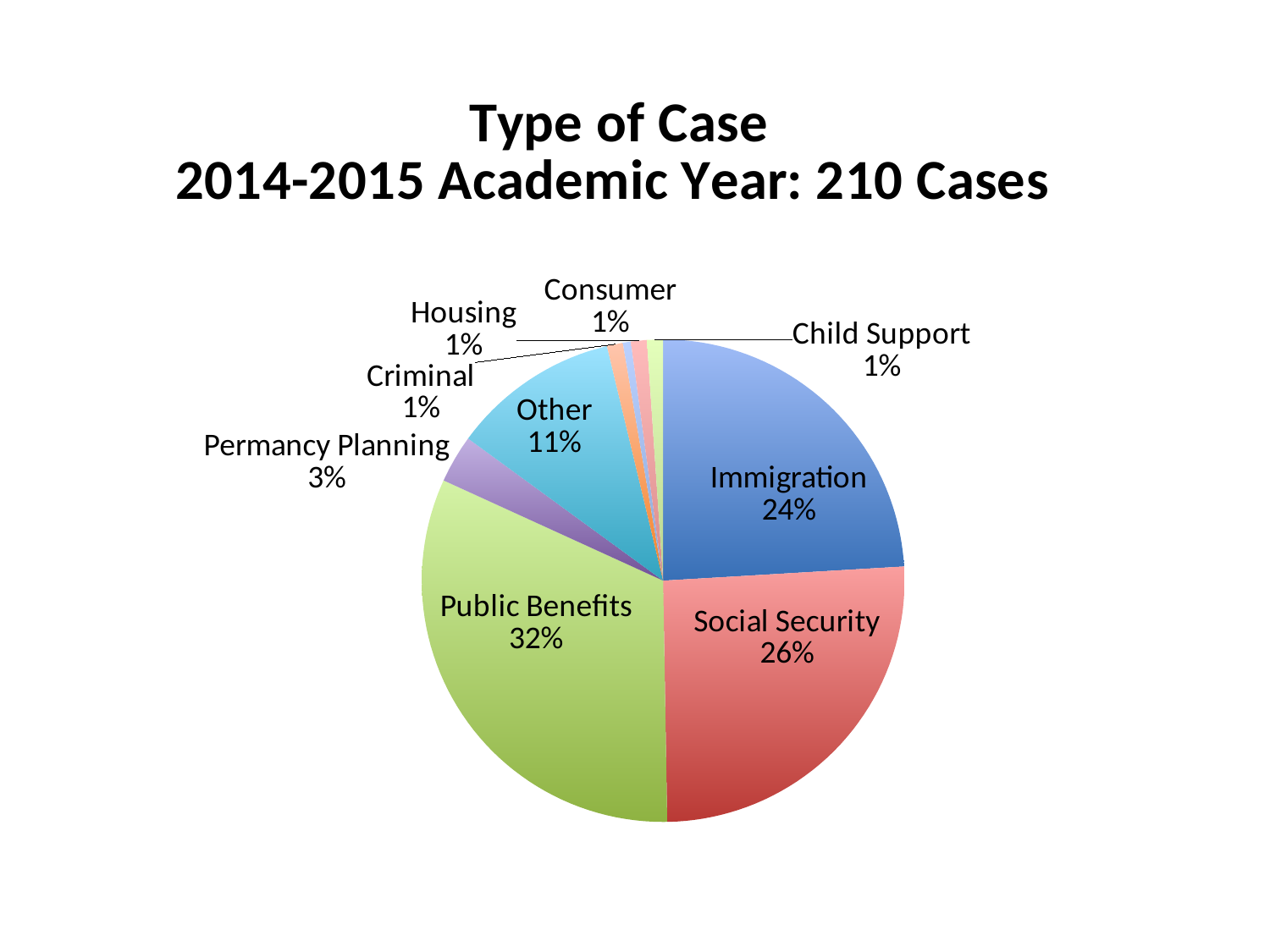
Which is larger, the share for Social Security or the share for Immigration? Social Security Which type of case has the largest share? Public Benefits What type of chart is shown on the slide? pie chart How many case types are shown in the pie chart? 9 What share of cases is Public Benefits? 32% What share of cases is Social Security? 26% What is the title of the chart? Type of Case 2014-2015 Academic Year: 210 Cases What share of cases is Other? 11% What is the difference in percentage points between Public Benefits and Immigration? 8 What colour is the Public Benefits slice? green